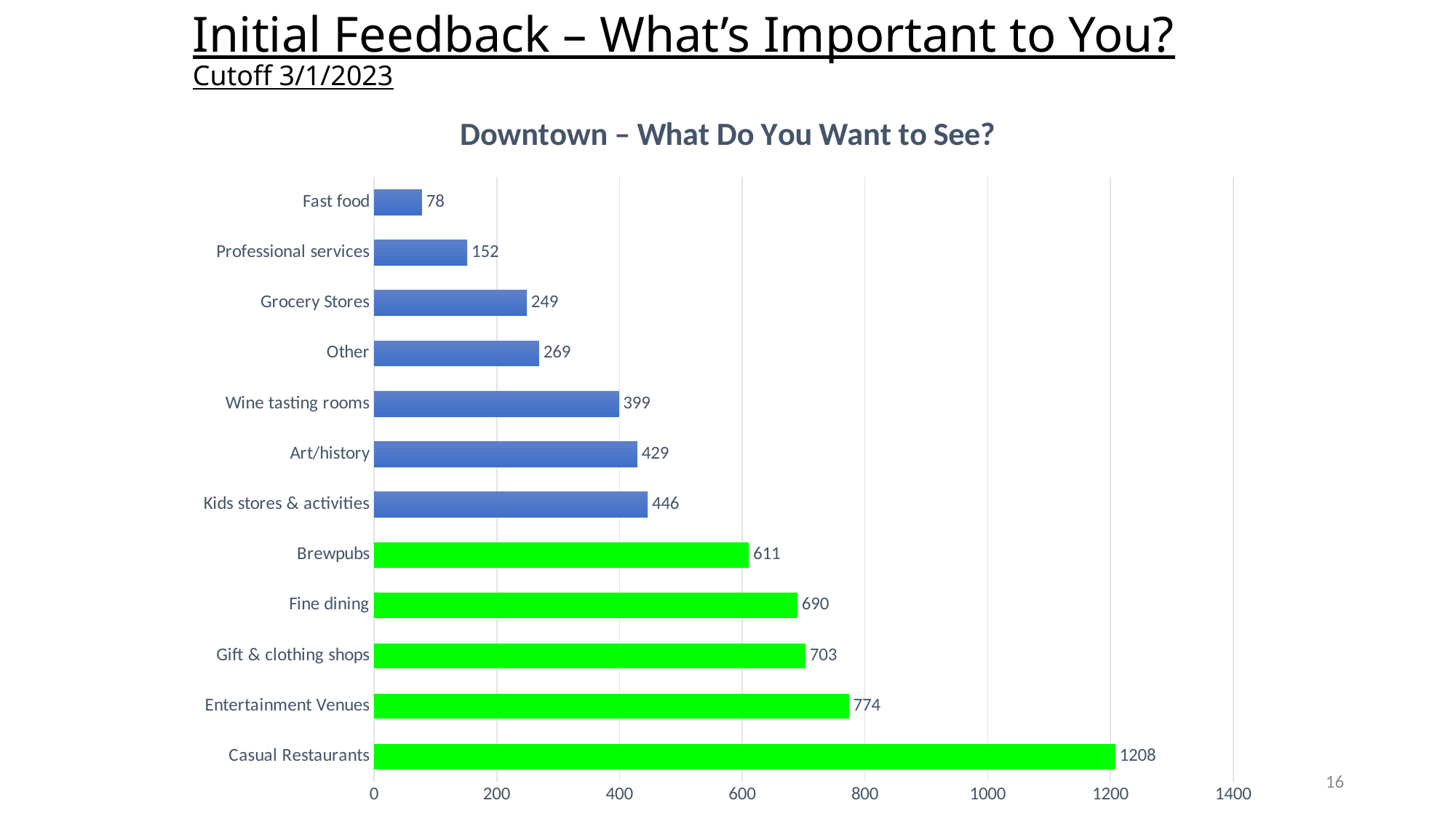
What is the title of the chart? Downtown – What Do You Want to See? Which category has the lowest value? Fast food Which is larger, the value for Fine dining or the value for Brewpubs? Fine dining What is the value for Casual Restaurants? 1208 What is the difference between the values for Casual Restaurants and Entertainment Venues? 434 Is the value for Gift & clothing shops greater or less than 600? greater What is the value for Professional services? 152 What is the value for Wine tasting rooms? 399 How many categories are shown in the chart? 12 What kind of chart is shown on the slide? bar chart What is the difference between the values for Brewpubs and Kids stores & activities? 165 Which category has the highest value? Casual Restaurants